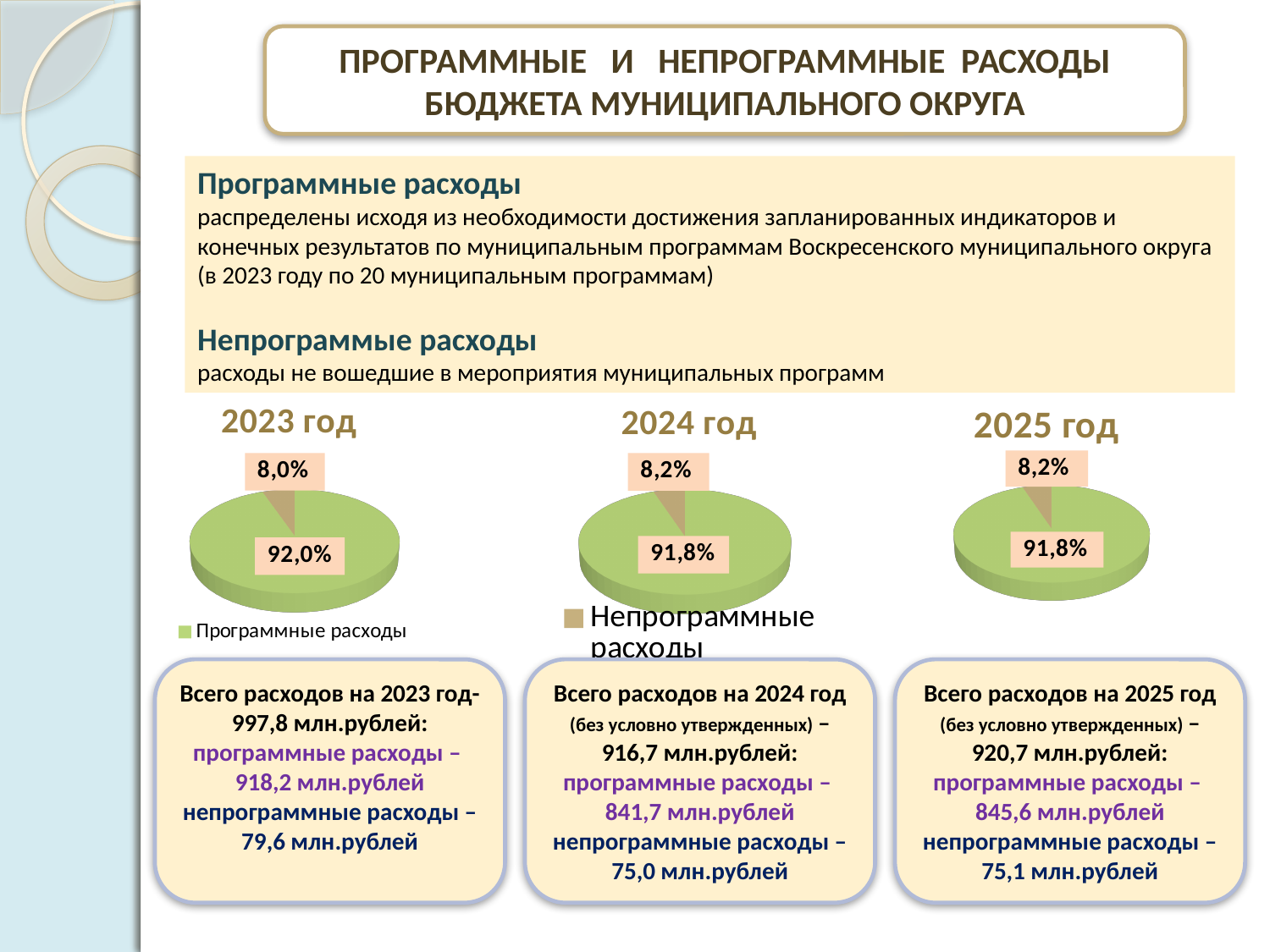
На круговой диаграмме «2023 год» на сколько процентных пунктов доля программных расходов больше доли непрограммных? 84,0% На круговой диаграмме «2024 год» какая доля приходится на непрограммные расходы? 8,2% На круговой диаграмме «2023 год» какая доля приходится на непрограммные расходы? 8,0% Какого типа диаграммы показаны на слайде для 2023, 2024 и 2025 годов? Круговые диаграммы На круговой диаграмме «2025 год» какая доля приходится на программные расходы? 91,8% На круговой диаграмме «2025 год» какой сектор наименьший? Непрограммные расходы Каким цветом на круговых диаграммах обозначены программные расходы? Зелёным Сколько секторов на круговой диаграмме «2024 год»? 2 На круговой диаграмме «2023 год» какая доля приходится на программные расходы? 92,0% Как меняется доля непрограммных расходов от диаграммы «2023 год» к диаграмме «2024 год»? Растёт (с 8,0% до 8,2%) На круговой диаграмме «2024 год» какой сектор больше — программные или непрограммные расходы? Программные расходы Сколько круговых диаграмм показано на слайде? 3